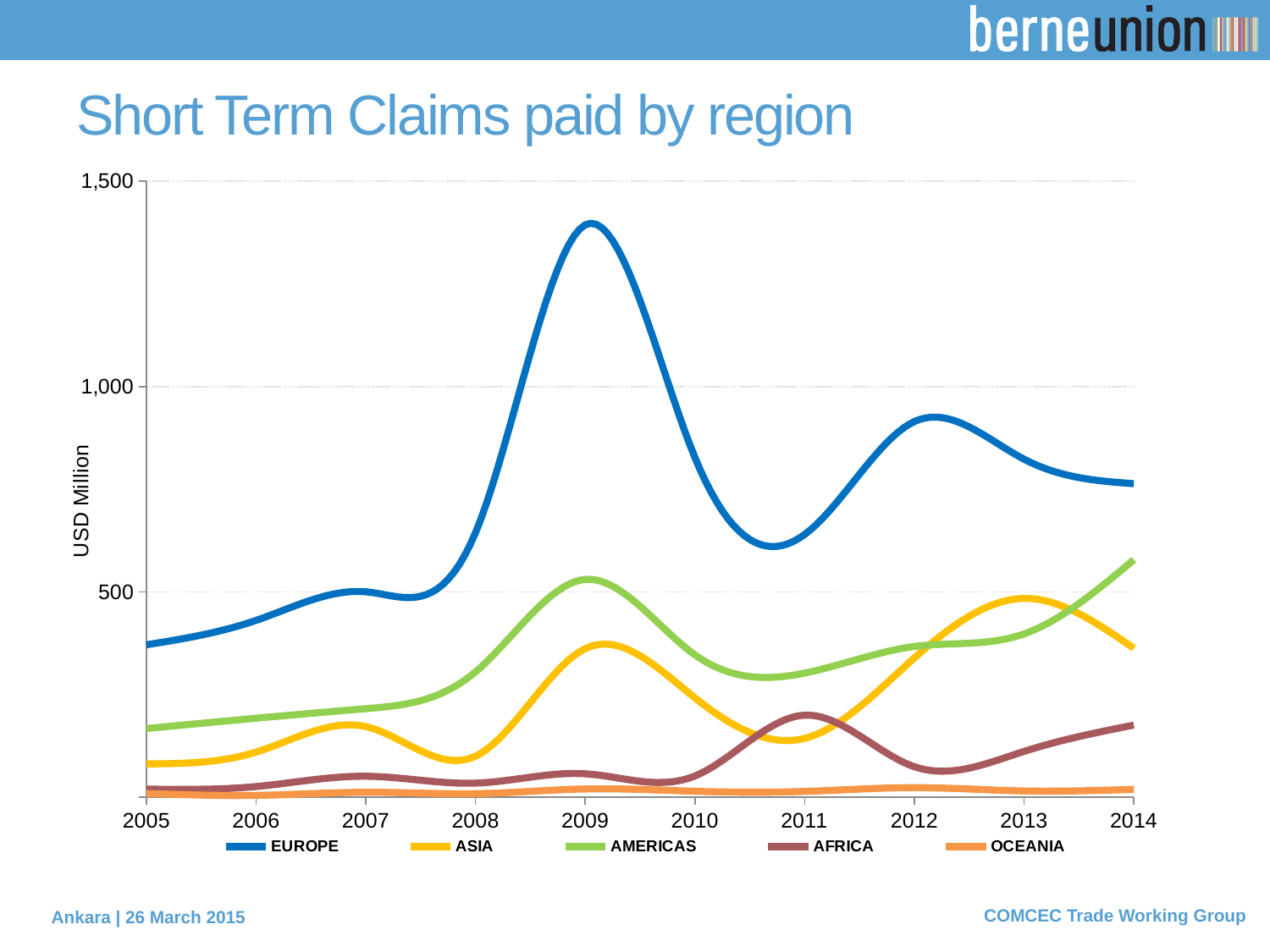
In 2009, which is larger: the value for EUROPE or the value for ASIA? EUROPE In which year does the EUROPE line reach its highest value? 2009 Is the value for EUROPE in 2009 greater or less than 1,000? greater Is the value for AMERICAS in 2014 greater or less than 500? greater How many years are shown on the x axis? 10 What is the label on the y axis? USD Million Is the value for EUROPE in 2012 greater or less than 1,000? less What kind of chart is shown on the slide? line chart In 2014, which is larger: the value for AMERICAS or the value for ASIA? AMERICAS How many series does the legend list? 5 Which region has the lowest values across all years shown? OCEANIA